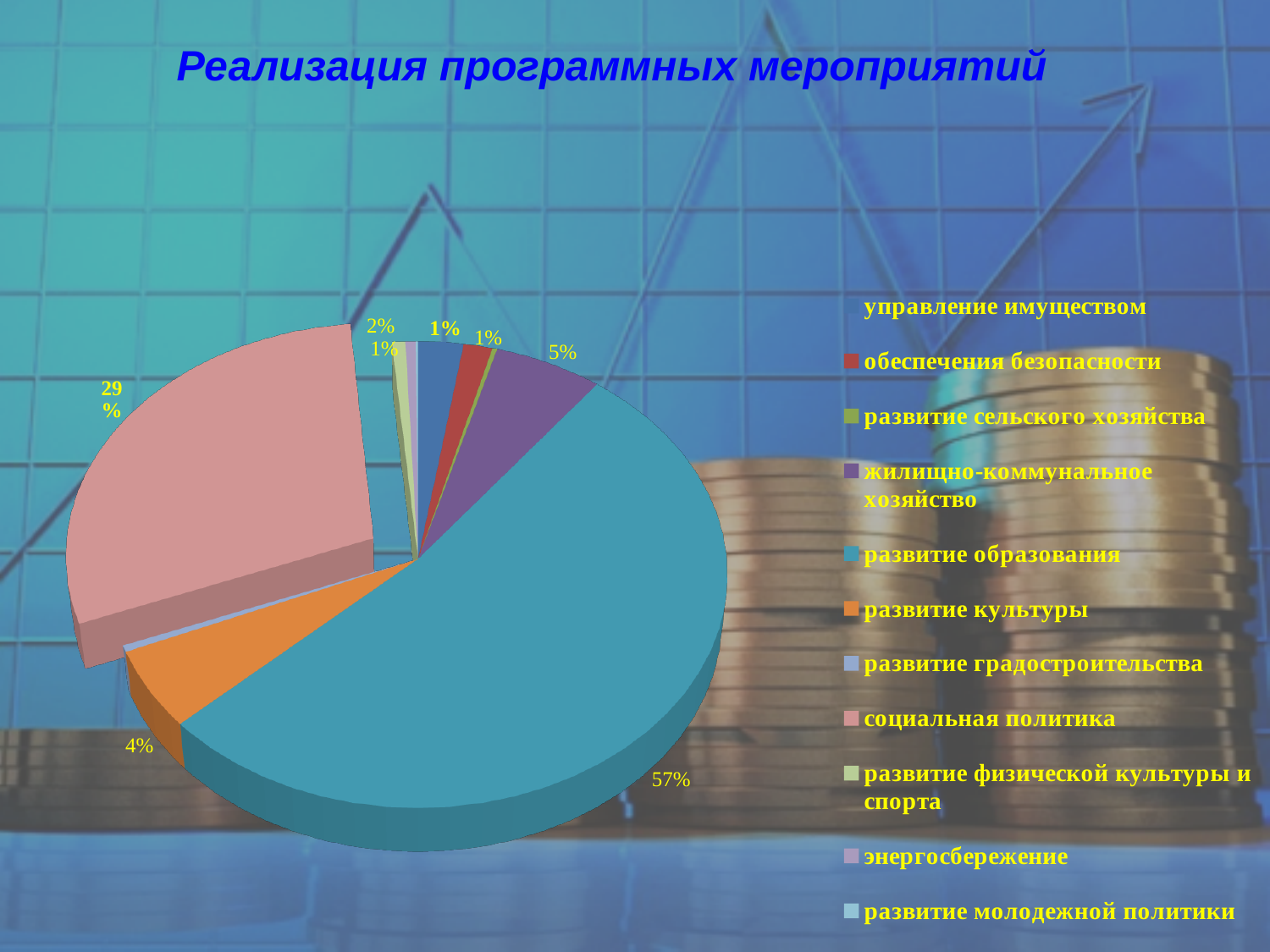
Which category has the largest slice of the pie? развитие образования What is the difference in percentage points between развитие образования and социальная политика? 28 Which is larger: the slice for социальная политика or the slice for развитие образования? развитие образования What is the title of the chart on the slide? Реализация программных мероприятий How many entries does the chart legend list? 11 What share of the pie does жилищно-коммунальное хозяйство have? 5% Which is larger: the slice for жилищно-коммунальное хозяйство or the slice for развитие культуры? жилищно-коммунальное хозяйство What share of the pie does развитие образования have? 57% What share of the pie does развитие культуры have? 4% What colour is the slice for развитие образования? teal What share of the pie does социальная политика have? 29% What kind of chart is shown on the slide? pie chart